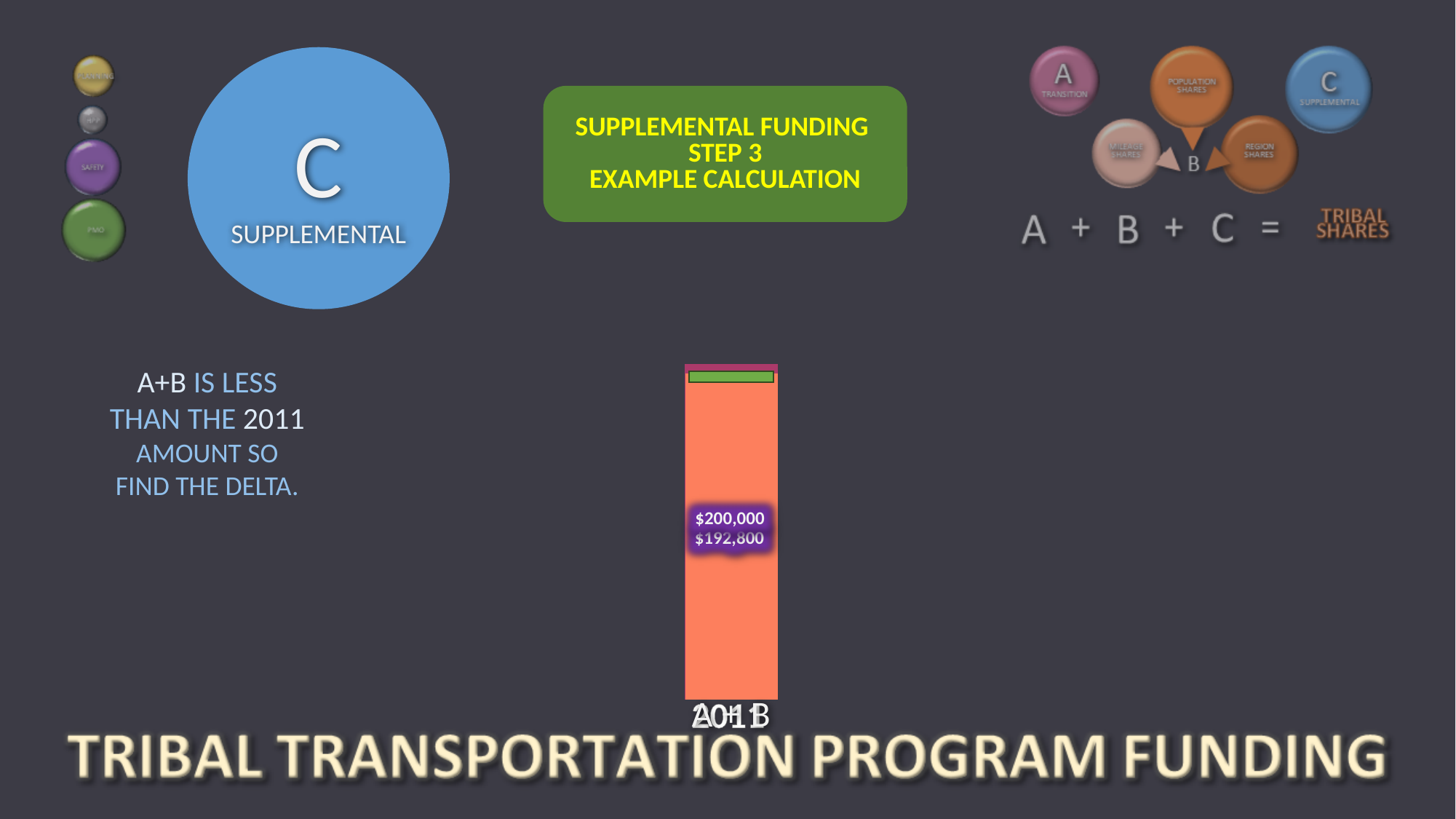
What is the A+B amount shown on the bar? $192,800 What is the difference between the two values printed on the bar, $200,000 and $192,800? $7,200 What is the smaller of the two values printed on the bar? $192,800 What is the larger of the two values printed on the bar? $200,000 What is the large title text at the bottom of the slide? TRIBAL TRANSPORTATION PROGRAM FUNDING What kind of chart is shown on the slide? bar chart According to the slide, which is larger: the 2011 amount or A+B? the 2011 amount What is the 2011 amount shown on the bar? $200,000 What colour is the main body of the bar? orange